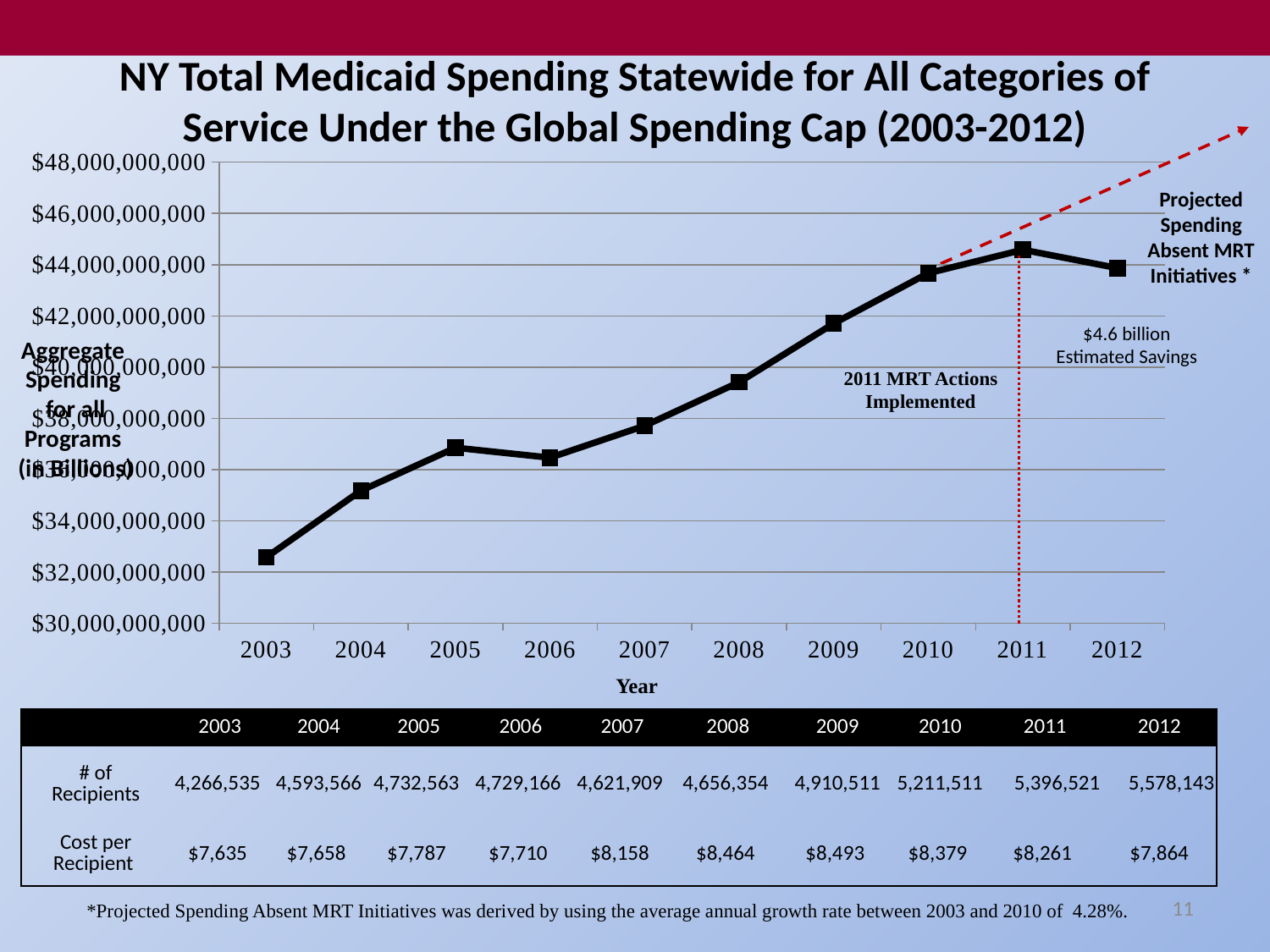
Which year has the lowest Medicaid spending on the chart? 2003 How many years are plotted on the x axis of the chart? 10 Which year has the highest Medicaid spending on the chart? 2011 Is the spending value for 2010 greater or less than $42,000,000,000? greater Which year has higher spending, 2011 or 2012? 2011 Is the spending value for 2011 greater or less than $44,000,000,000? greater What kind of chart is shown on the slide? line chart Which year has higher spending, 2004 or 2005? 2005 Is the spending value for 2003 greater or less than $34,000,000,000? less Does Medicaid spending generally rise or fall from 2003 to 2010? rise What is the label on the x axis of the chart? Year